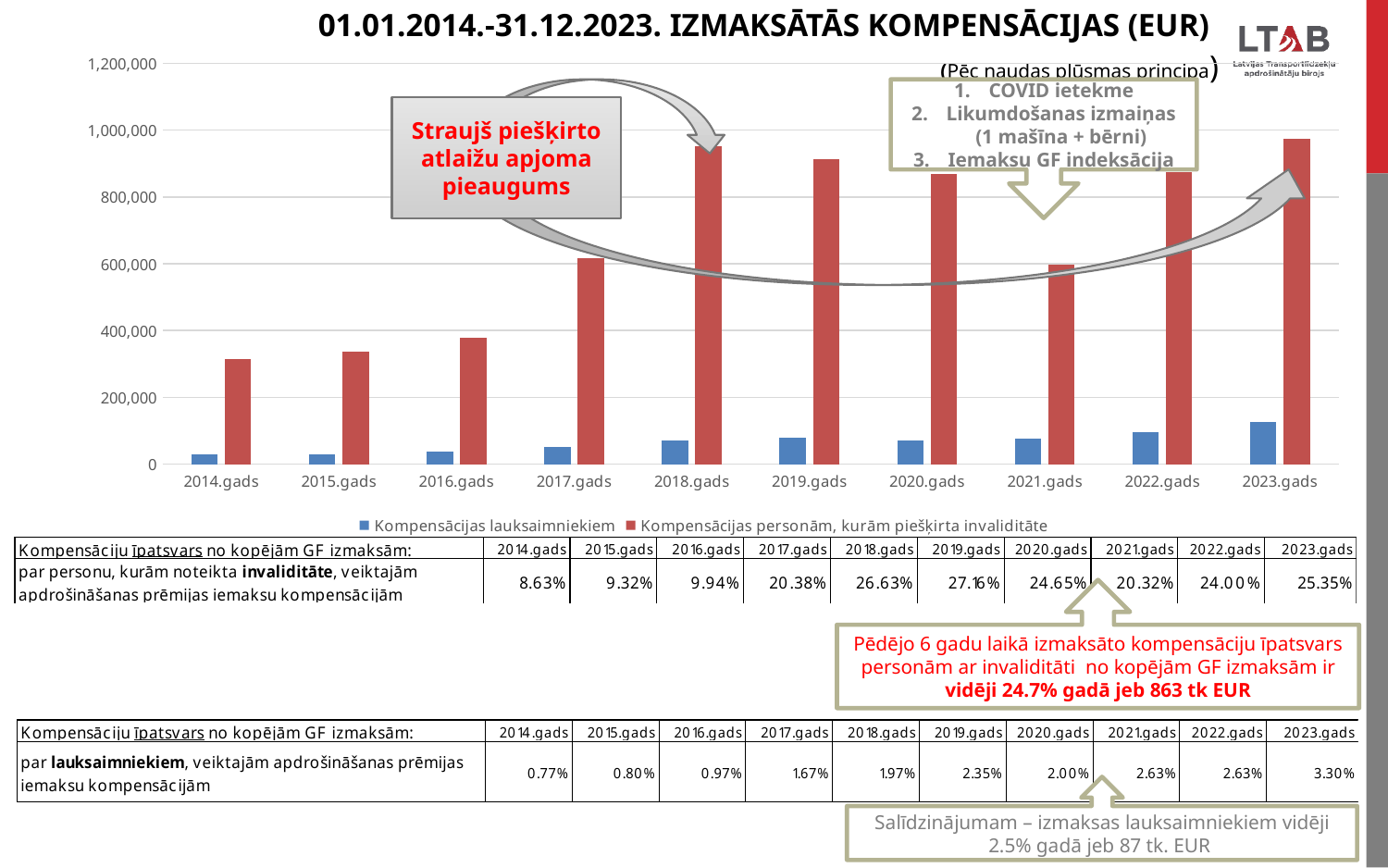
Do the values for Kompensācijas lauksaimniekiem generally rise or fall from 2014.gads to 2023.gads? rise How many series does the chart legend list? 2 Which year has the highest value for Kompensācijas lauksaimniekiem? 2023.gads Which is larger: Kompensācijas personām, kurām piešķirta invaliditāte in 2018.gads or in 2021.gads? 2018.gads Which series is shown in red in the chart? Kompensācijas personām, kurām piešķirta invaliditāte Which is larger: Kompensācijas personām, kurām piešķirta invaliditāte in 2016.gads or in 2017.gads? 2017.gads Is the value for Kompensācijas personām, kurām piešķirta invaliditāte in 2014.gads greater or less than 400,000? less Is the value for Kompensācijas lauksaimniekiem in 2023.gads greater or less than 200,000? less Is the value for Kompensācijas personām, kurām piešķirta invaliditāte in 2018.gads greater or less than 800,000? greater What kind of chart is shown on the slide? bar chart How many years (categories) are shown on the x axis of the chart? 10